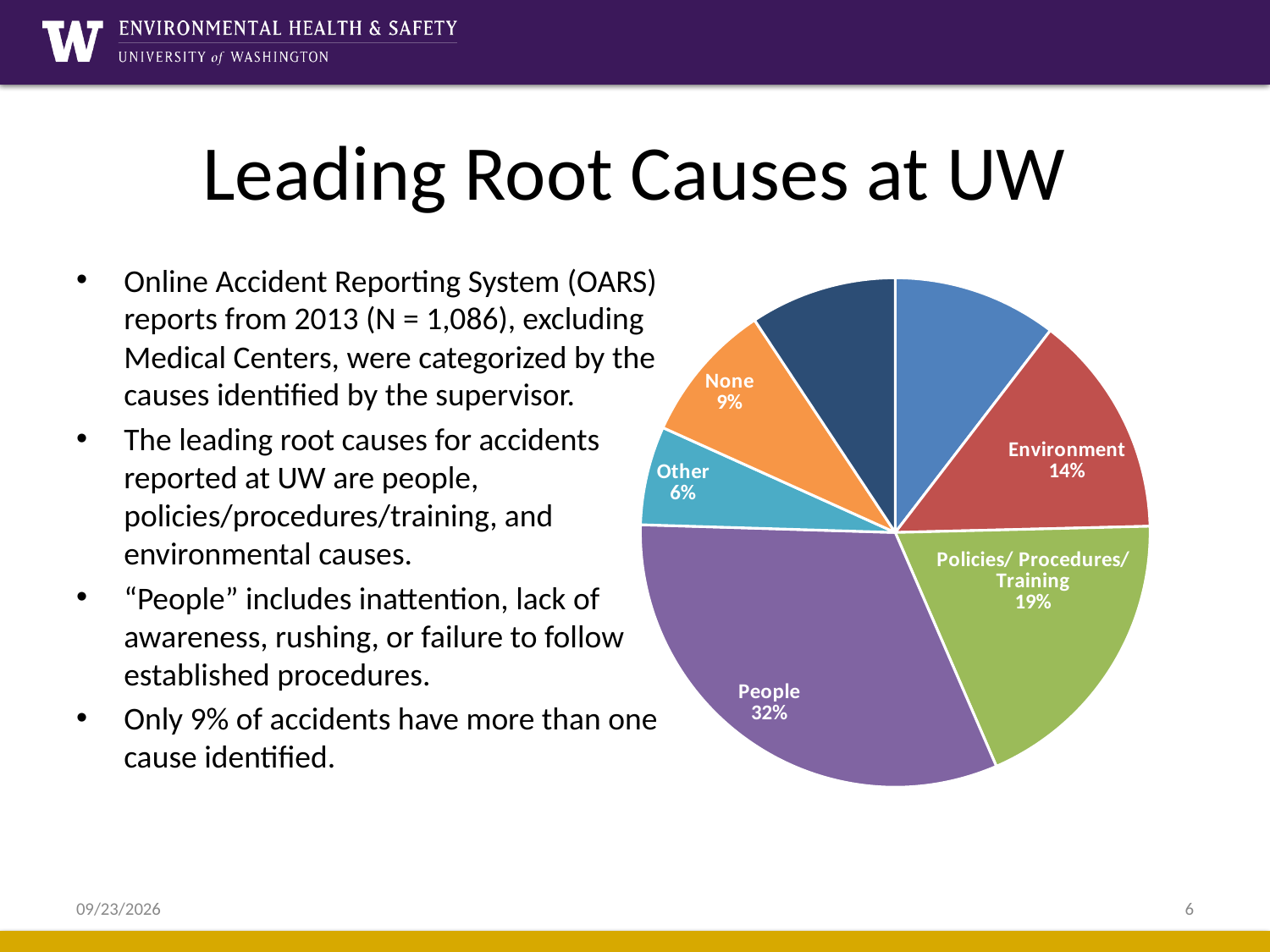
Which slice of the pie is the largest? People What percentage is shown for the Other slice? 6% How many slices does the pie chart have? 7 What percentage is shown for the Policies/ Procedures/ Training slice? 19% How many percentage points larger is the People slice than the Environment slice? 18 What colour is the People slice in the pie chart? purple Which slice of the pie is the smallest? Other What percentage is shown for the None slice? 9% What kind of chart is shown on the slide? pie chart What percentage is shown for the Environment slice? 14% Which is larger, the Environment slice or the Policies/ Procedures/ Training slice? Policies/ Procedures/ Training What share of the pie does the People slice represent? 32%